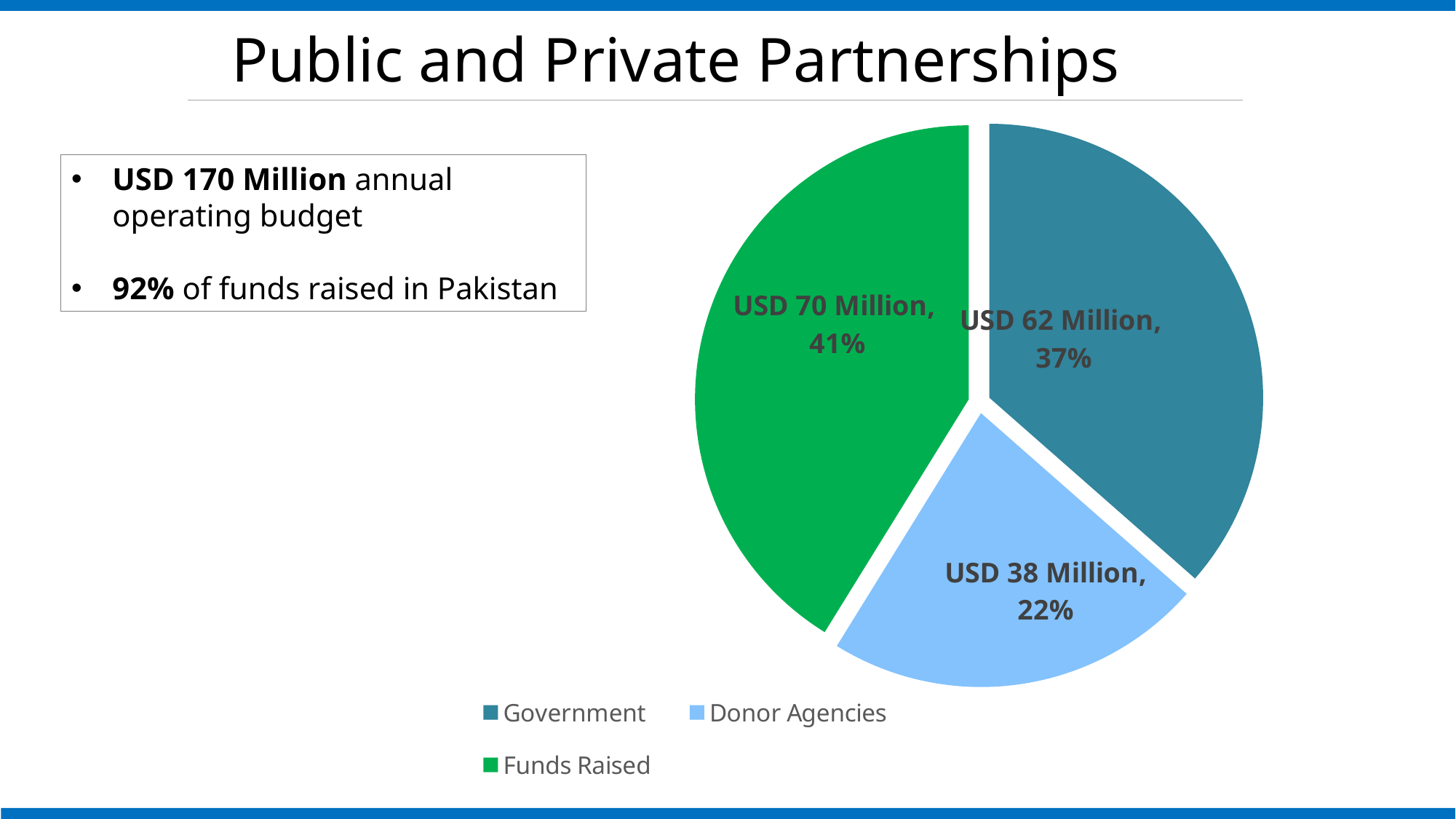
What colour is the Funds Raised slice? Green What kind of chart is shown on the slide? Pie chart What is the value for Funds Raised? USD 70 Million What share of the pie does Funds Raised represent? 41% What is the value for Donor Agencies? USD 38 Million Which is larger, Government or Donor Agencies? Government What share of the pie does Donor Agencies represent? 22% Which category has the largest slice? Funds Raised Which category has the smallest slice? Donor Agencies What is the difference between the Funds Raised and Government values? USD 8 Million How many slices does the pie chart have? 3 What is the value for Government? USD 62 Million